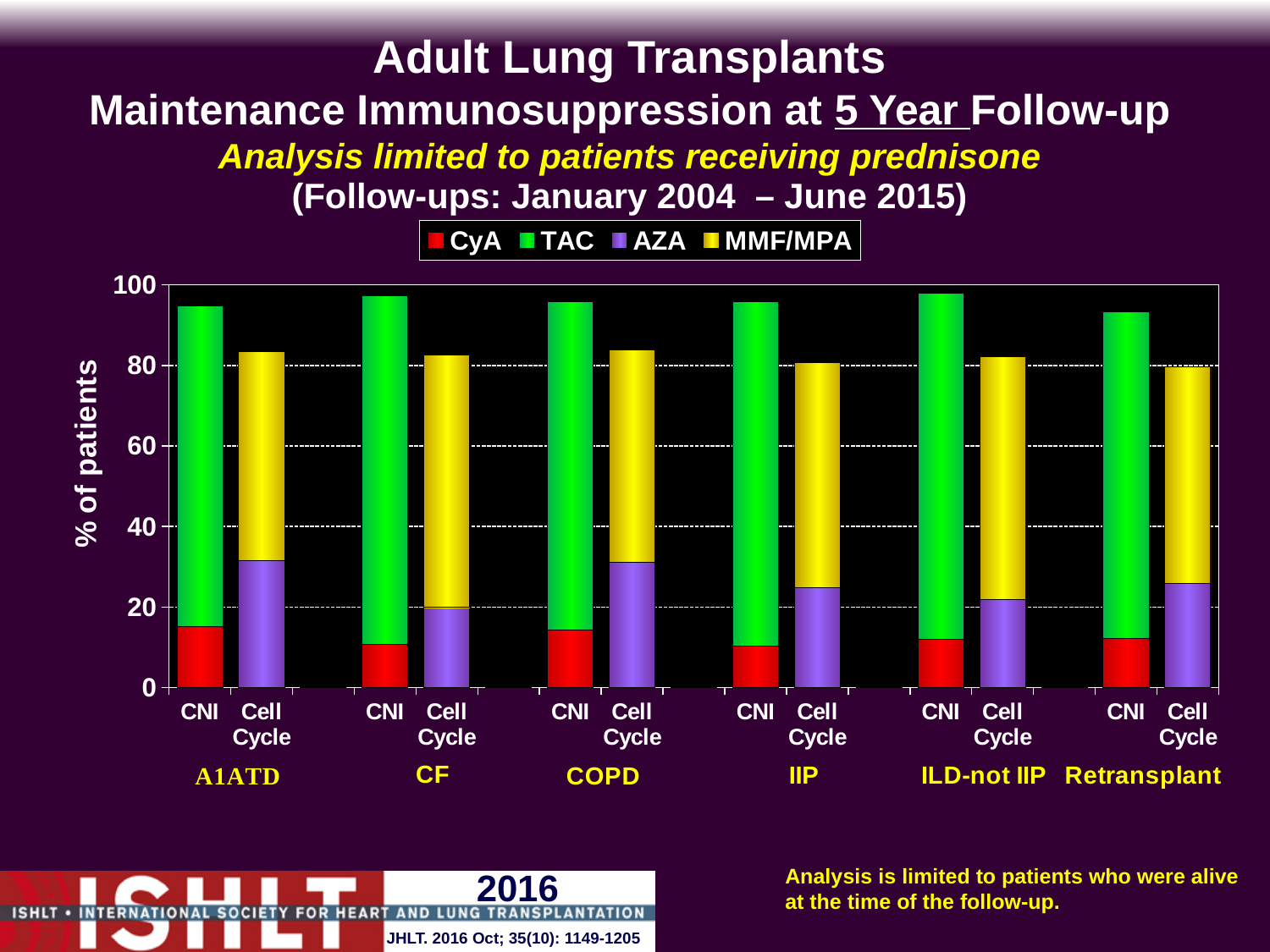
Which legend entry is shown in yellow? MMF/MPA Is the total height of the Cell Cycle bar for COPD greater or less than 100? less How many series does the legend list? 4 How many diagnosis groups are shown along the x axis? 6 Is the total height of the CNI bar for A1ATD greater or less than 80? greater Is the CyA segment of the CNI bar for CF greater or less than 20? less For A1ATD, which bar is taller, CNI or Cell Cycle? CNI Which is larger, the AZA segment for A1ATD or the AZA segment for CF? A1ATD What is the label of the y axis? % of patients What kind of chart is shown on the slide? Stacked bar chart How many bars are plotted in total on the chart? 12